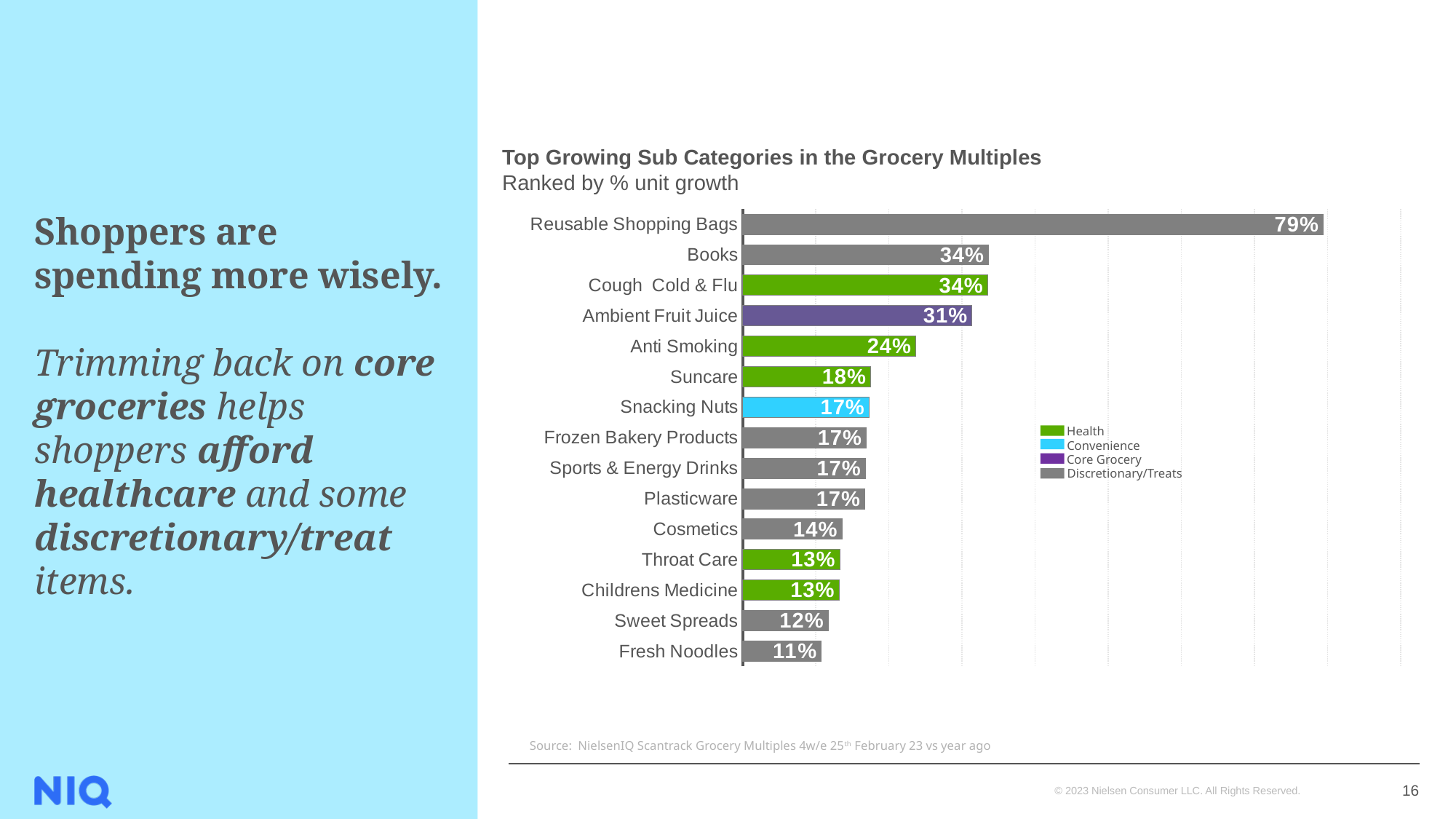
What is the % unit growth for Reusable Shopping Bags? 79% What is the % unit growth for Fresh Noodles? 11% What is the difference in % unit growth between Reusable Shopping Bags and Books? 45% How many sub categories are shown in the chart? 15 Which sub category has the lowest % unit growth? Fresh Noodles What is the % unit growth for Ambient Fruit Juice? 31% Which has higher % unit growth, Suncare or Cosmetics? Suncare Which legend category does the Snacking Nuts bar belong to? Convenience What is the % unit growth for Anti Smoking? 24% Which sub category has the highest % unit growth? Reusable Shopping Bags What kind of chart is shown on the slide? Bar chart How many series does the legend list? 4